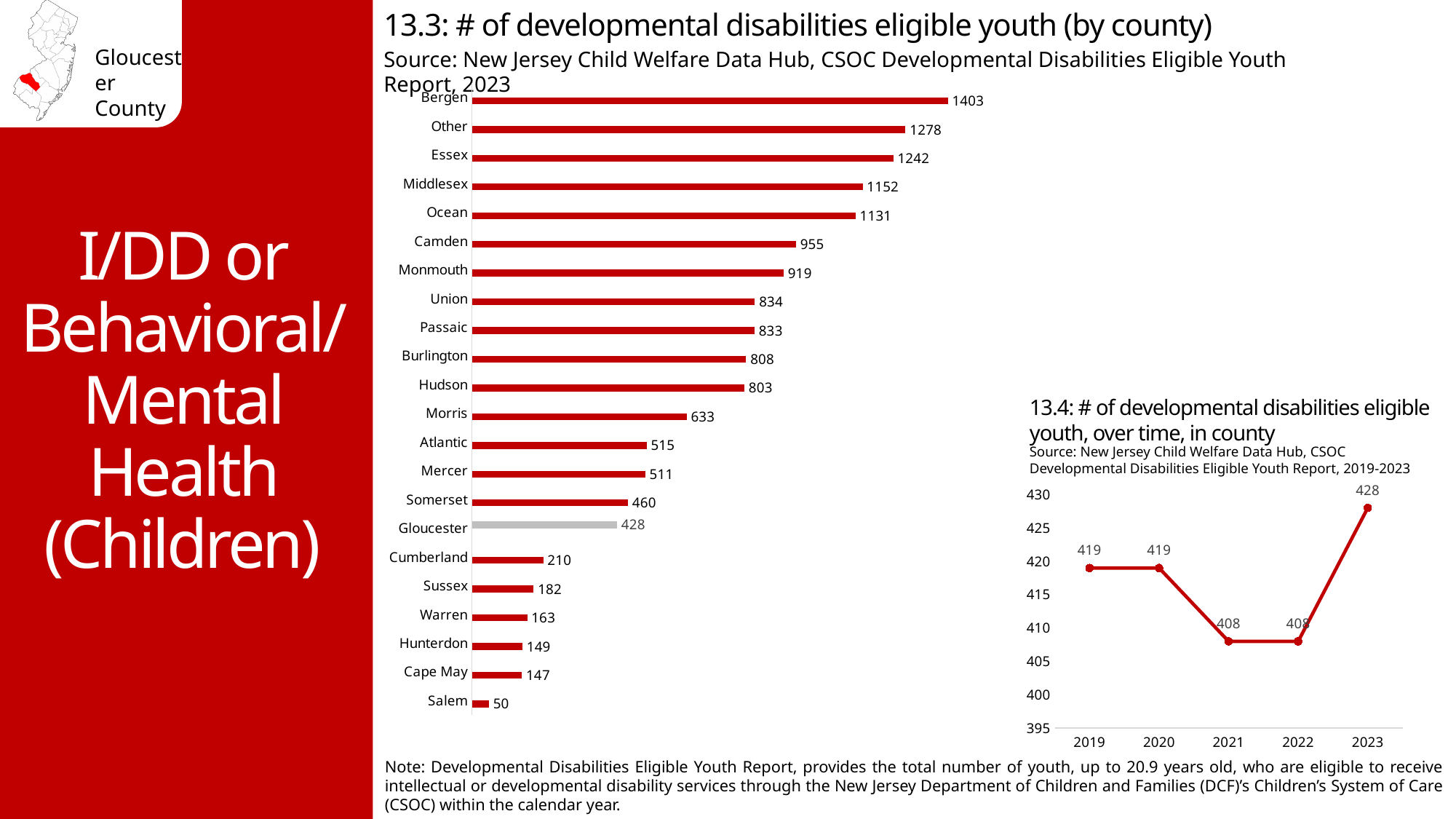
In chart 13.4 (over time, in county), what is the value for 2023? 428 In chart 13.3 (by county), which has a larger value, Morris or Atlantic? Morris In chart 13.3 (# of developmental disabilities eligible youth by county), what is the value for Gloucester? 428 What kind of chart is chart 13.3 (# of developmental disabilities eligible youth by county)? Bar chart In chart 13.3 (by county), which bar is shown in grey rather than red? Gloucester In chart 13.3 (by county), what is the difference between Bergen and Gloucester? 975 In chart 13.3 (by county), how many bars are shown? 22 In chart 13.4 (over time, in county), what is the difference between the 2023 value and the 2022 value? 20 In chart 13.3 (by county), which county has the lowest number of eligible youth? Salem In chart 13.4 (over time, in county), how many years are plotted? 5 In chart 13.3 (by county), which county has the highest number of eligible youth? Bergen In chart 13.3 (by county), what is the value for Camden? 955